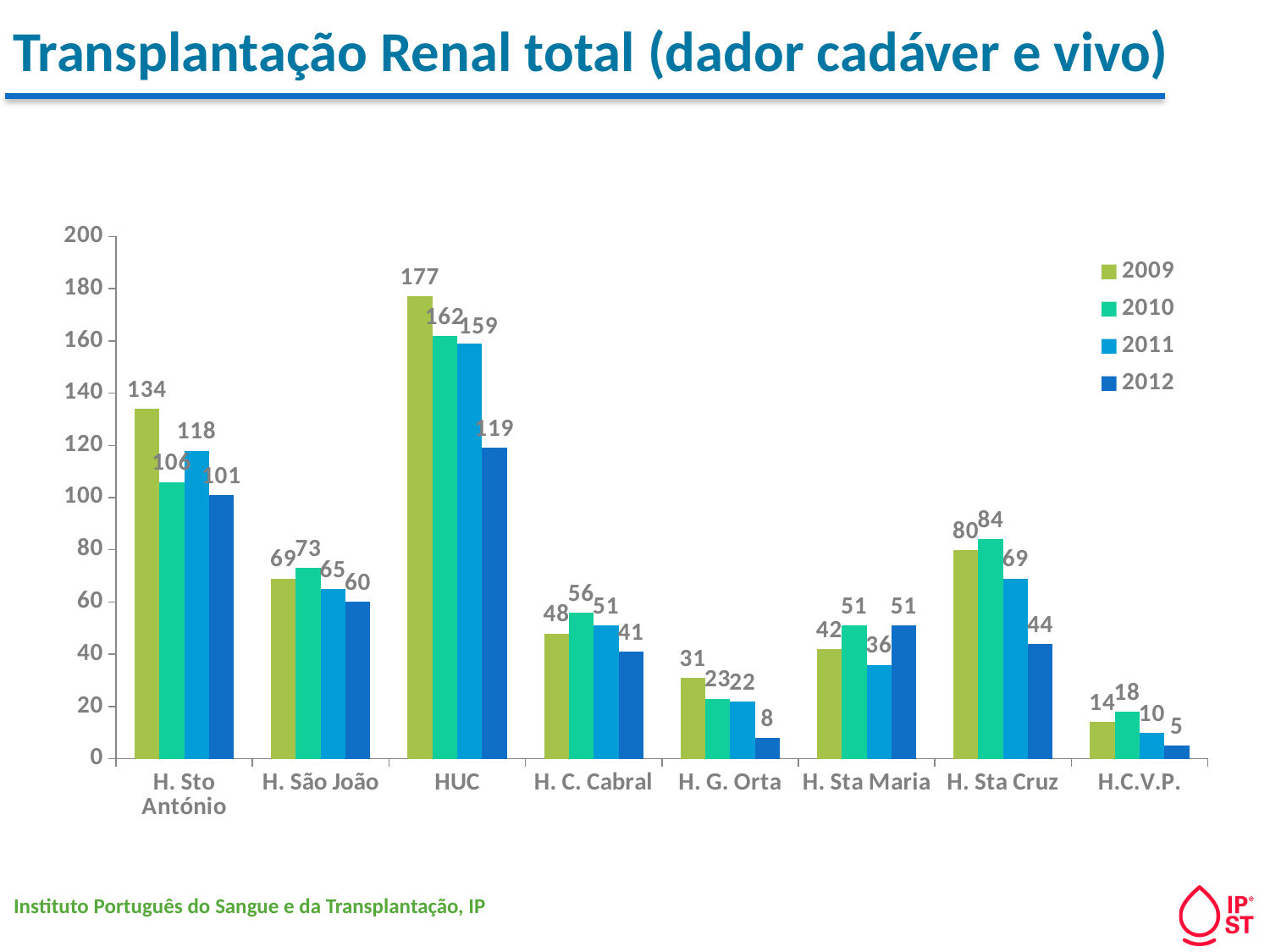
What is the title of the chart? Transplantação Renal total (dador cadáver e vivo) What is the value for H. Sta Cruz in 2011? 69 Which hospital has the highest value in 2012? HUC How many series does the legend list? 4 What is the difference between the 2009 and 2012 values for HUC? 58 What is the value for H. G. Orta in 2012? 8 What is the value for HUC in 2009? 177 Which is larger for H. Sta Maria: the 2009 value or the 2012 value? 2012 What kind of chart is shown on the slide? bar chart How many hospitals are shown on the x axis? 8 Do the values for H. São João rise or fall from 2010 to 2012? fall Which hospital has the lowest value in 2010? H.C.V.P.